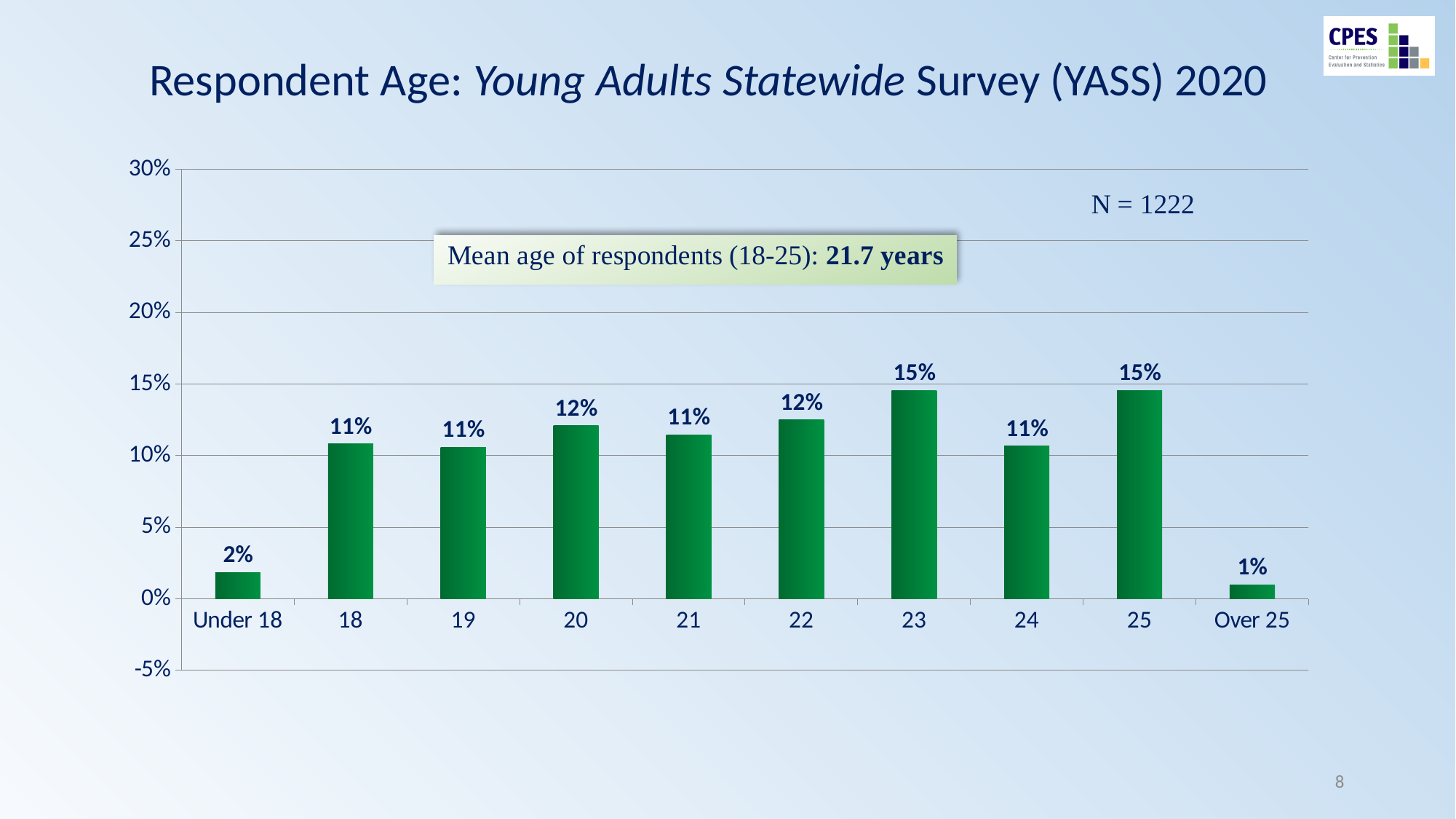
Which has a larger share of respondents, age 25 or age 24? 25 What is the mean age of respondents (18-25) stated on the slide? 21.7 years What percentage of respondents were under 18? 2% How many age categories are shown on the x axis? 10 Which age category has the lowest percentage of respondents? Over 25 What kind of chart is shown on the slide? Bar chart What percentage of respondents were age 20? 12% Is the value for age 22 greater or less than 10%? greater What percentage of respondents were age 23? 15% What percentage of respondents were over 25? 1% What is the difference in percentage points between respondents aged 23 and those under 18? 13% What is the sample size (N) shown on the chart? N = 1222